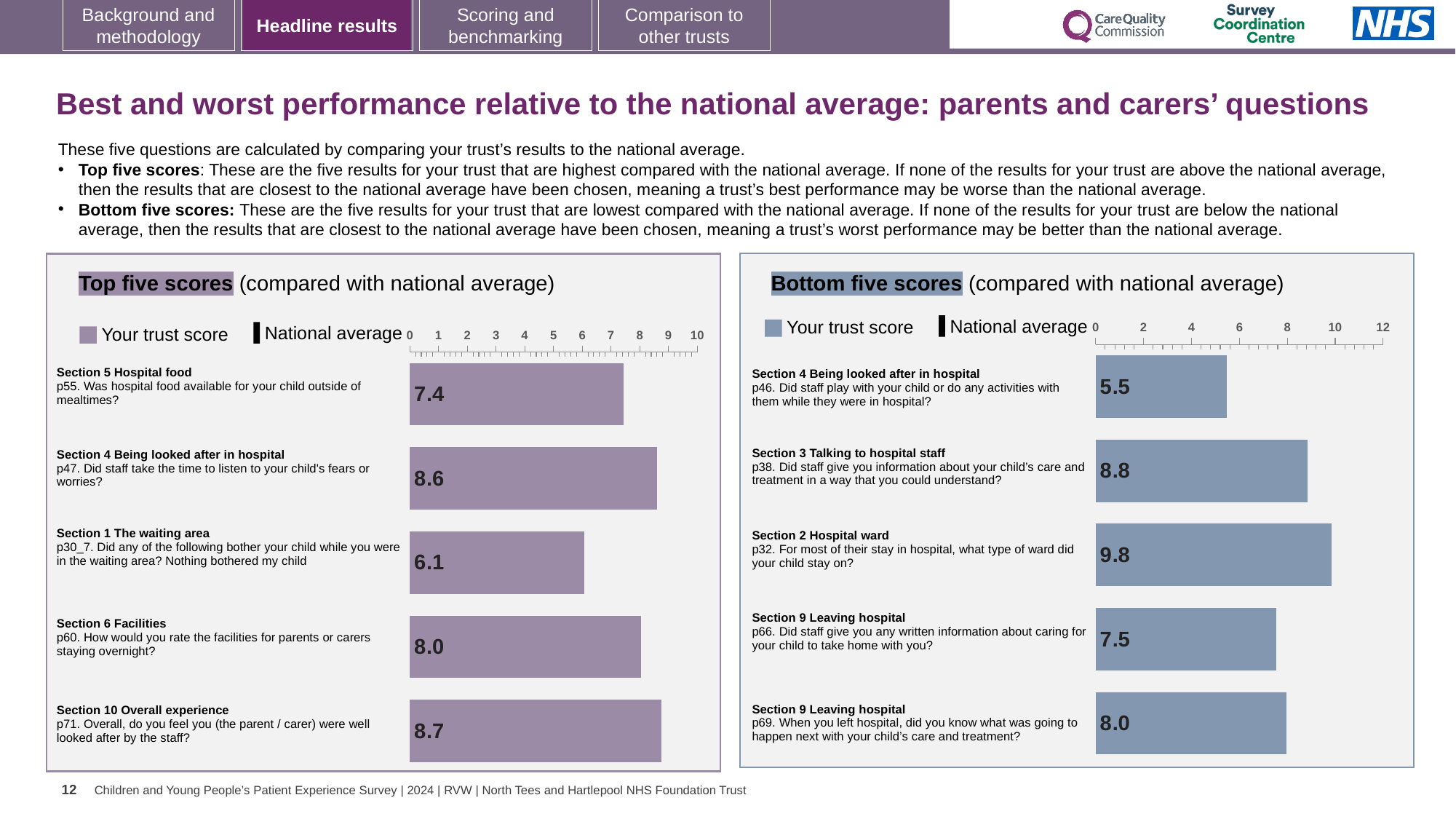
What type of chart is the Top five scores chart? Bar chart In the Top five scores chart, which question has the lowest trust score? p30_7. Did any of the following bother your child while you were in the waiting area? Nothing bothered my child In the Bottom five scores chart, what is the trust score for p46 (Did staff play with your child or do any activities with them while they were in hospital?)? 5.5 In the Bottom five scores chart, which question has the lowest trust score? p46. Did staff play with your child or do any activities with them while they were in hospital? In the Top five scores chart, how many questions are plotted? 5 In the Top five scores chart, what is the difference between the trust scores for p47 and p60? 0.6 In the Bottom five scores chart, what is the difference between the trust scores for p32 and p69? 1.8 In the Top five scores chart, what is the trust score for p55 (Was hospital food available for your child outside of mealtimes?)? 7.4 In the Bottom five scores chart, which has the larger trust score: p38 or p66? p38 In the Bottom five scores chart, which question has the highest trust score? p32. For most of their stay in hospital, what type of ward did your child stay on? In the Top five scores chart, which question has the highest trust score? p71. Overall, do you feel you (the parent / carer) were well looked after by the staff? How many entries does the legend of the Bottom five scores chart list? 2